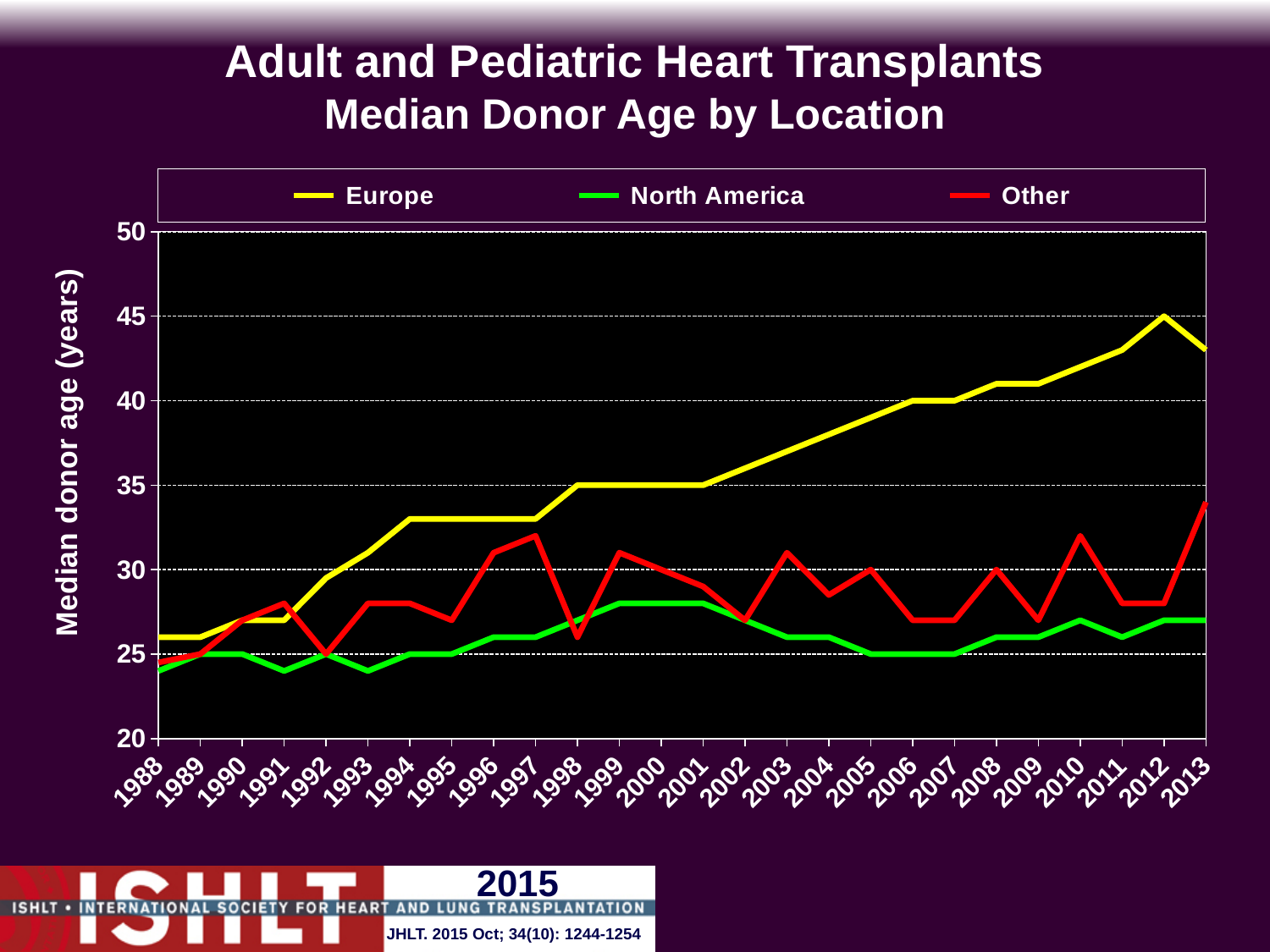
What is the median donor age for Europe in 2006? 40 In which year does the Europe series reach its highest value? 2012 In 2013, which series has the larger value, Europe or North America? Europe How many years are shown along the x axis? 26 How many series does the legend list? 3 Is the value for North America in 2013 greater or less than 30? less Is the value for Other in 1997 greater or less than 30? greater What is the median donor age for Europe in 2012? 45 Is the value for Europe in 2013 greater or less than 40? greater What is the median donor age for North America in 2006? 25 Does the Europe series generally rise or fall from 1988 to 2013? rise What kind of chart is shown on the slide? line chart